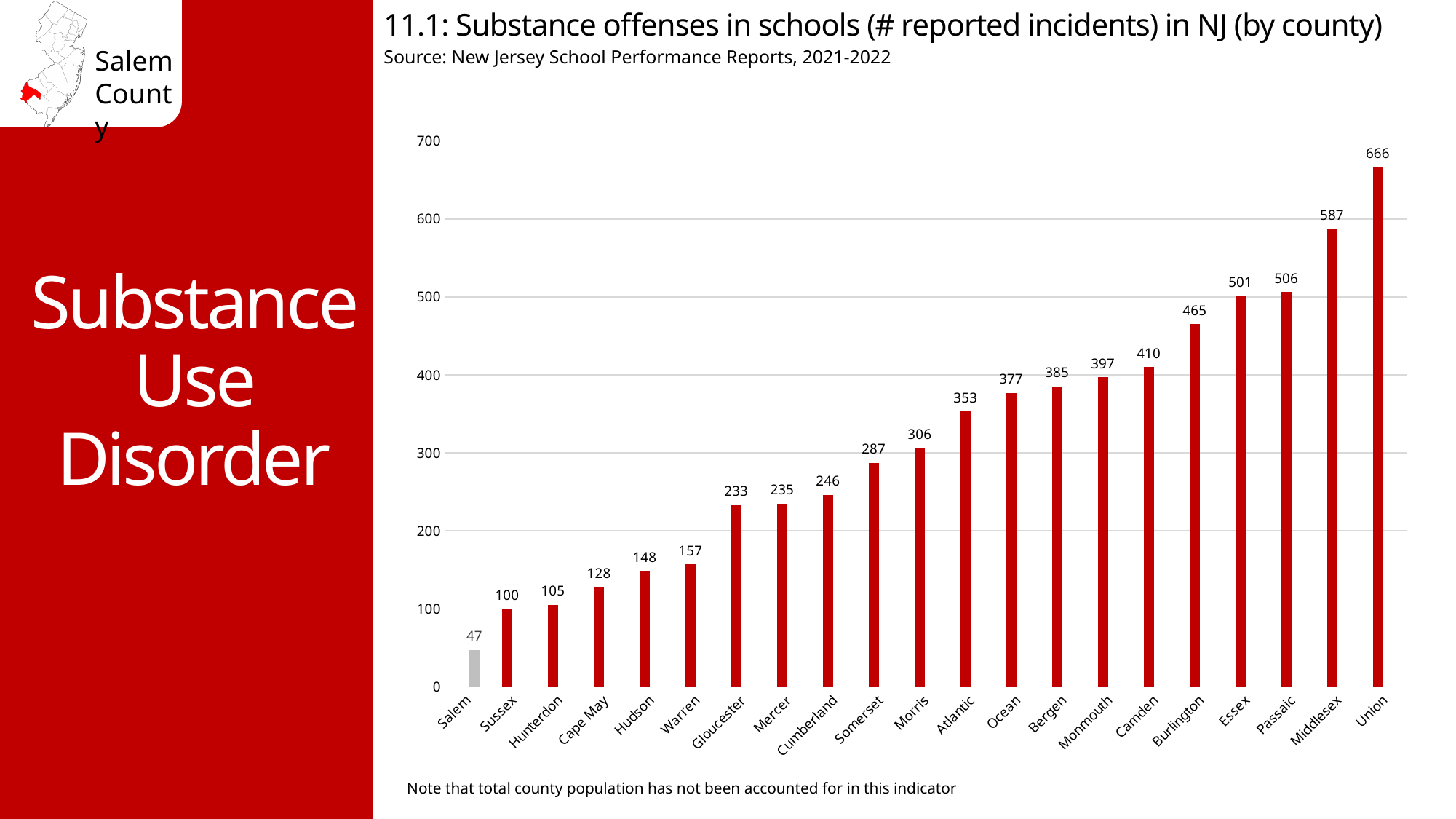
How many counties are shown on the x axis? 21 Do the values rise or fall moving from left to right along the x axis? Rise What is the value shown for Gloucester County? 233 Which has a higher value, Camden or Bergen? Camden What is the difference between the values for Passaic and Essex? 5 What is the value shown for Middlesex County? 587 Which county has the highest number of reported incidents? Union Is the value for Burlington greater or less than 400? greater Which county has the lowest number of reported incidents? Salem What kind of chart is this? Bar chart What is the number of reported substance offense incidents in schools for Salem County? 47 What is the difference between the values for Union and Salem? 619